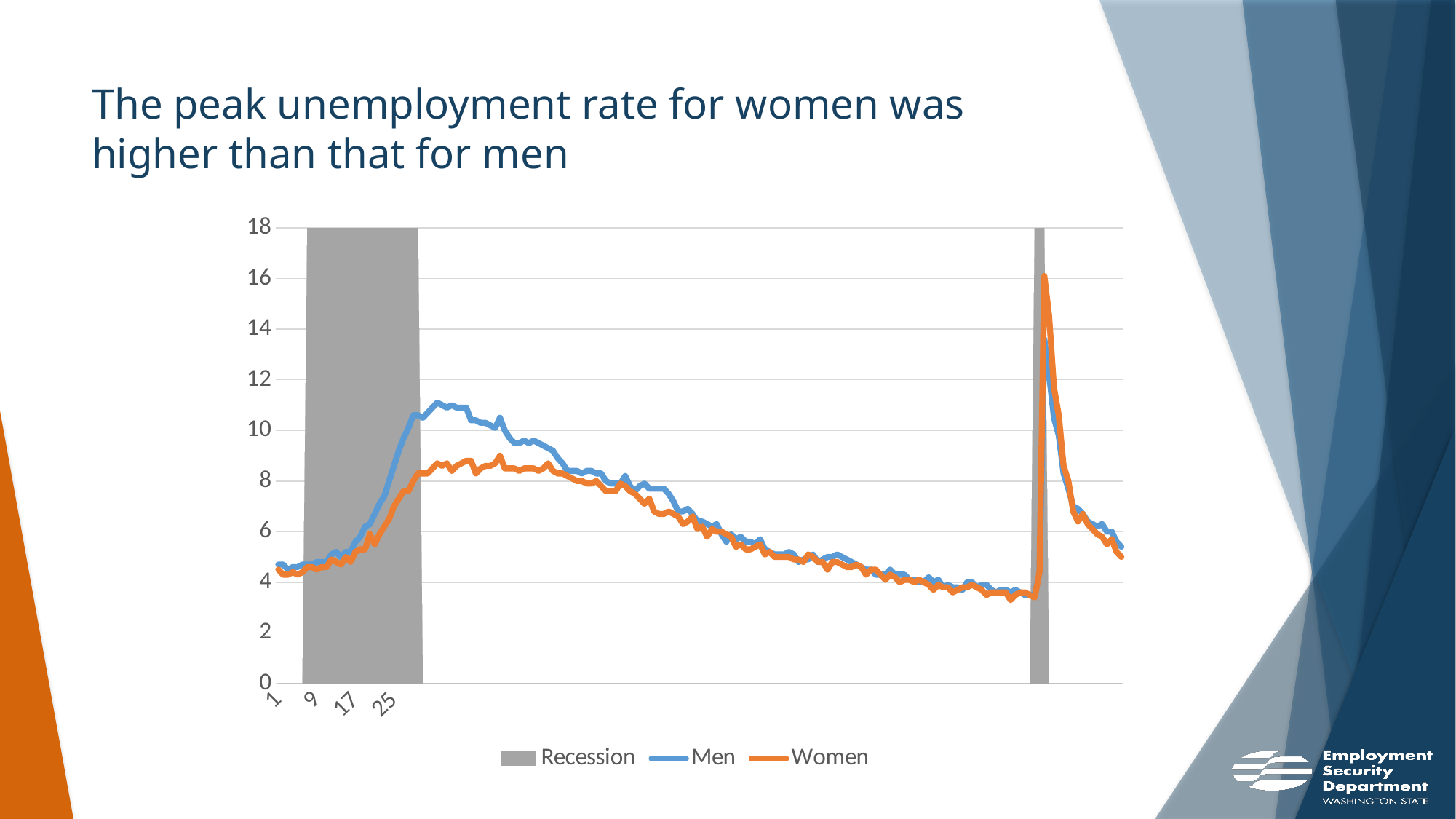
Which series reaches a higher peak around the first (wide) recession band, Men or Women? Men Is the highest value reached by the Men series during the first recession greater or less than 10? greater What does the grey shading in the chart represent? Recession Between the end of the first recession band and the start of the second, do the Men and Women values generally rise or fall? fall Which series is drawn in orange? Women Which series reaches a higher peak during the second (narrow) recession band, Men or Women? Women Is the highest value reached by the Women series during the first recession greater or less than 10? less How many shaded recession periods are shown on the chart? 2 Is the highest value reached by the Women series greater or less than 14? greater What kind of chart is shown on the slide? line chart How many entries does the chart legend list? 3